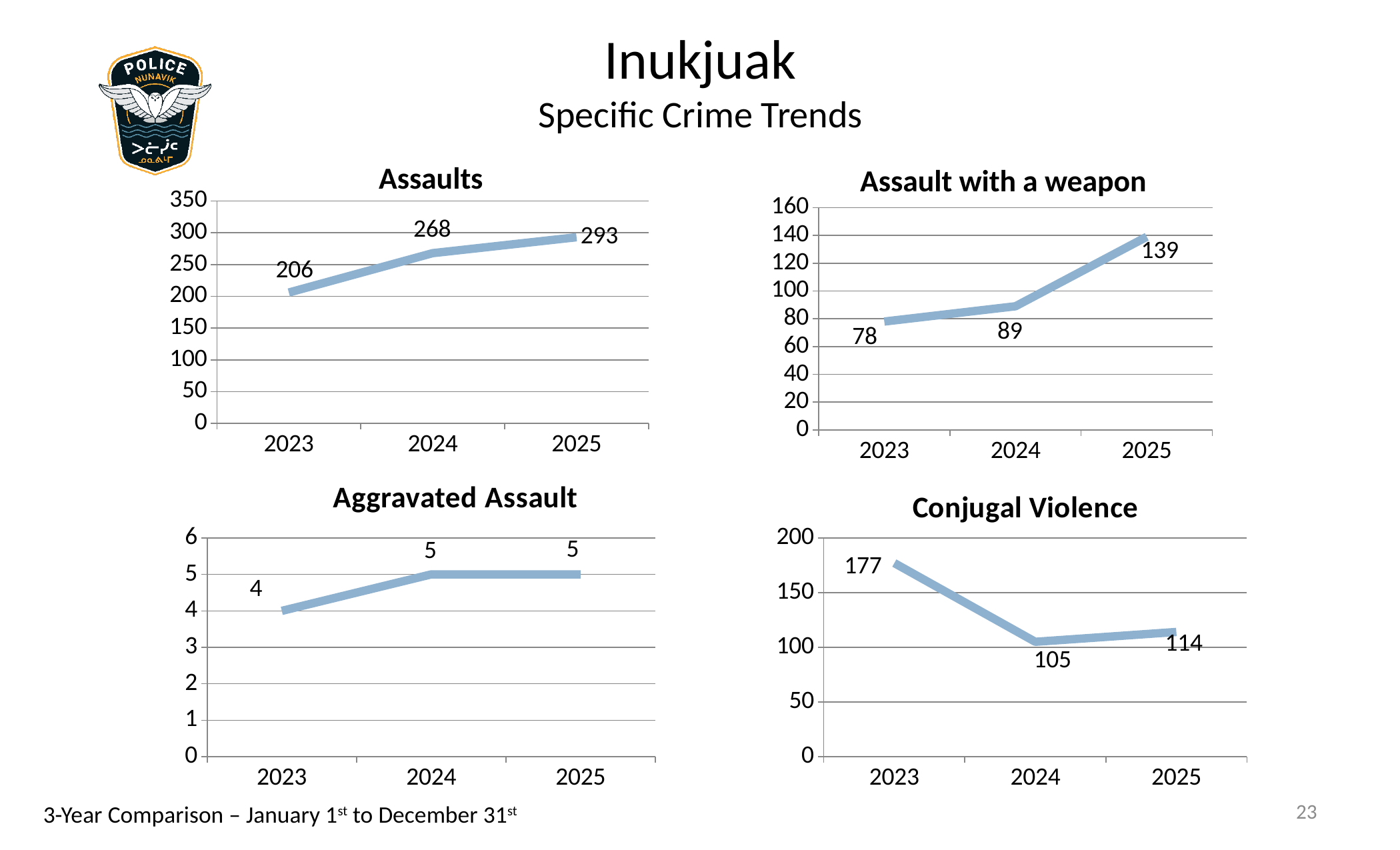
In the Aggravated Assault chart, which is larger, the value for 2023 or the value for 2024? 2024 In the Assault with a weapon chart, is the value for 2024 greater or less than 100? less How many charts are shown on the slide? 4 In the Conjugal Violence chart, which year has the highest value? 2023 In the Assault with a weapon chart, which year has the lowest value? 2023 In the Assault with a weapon chart, what is the value for 2025? 139 In the Assault with a weapon chart, do the values rise or fall from 2023 to 2025? rise In the Assaults chart, what is the difference between the 2025 and 2023 values? 87 What kind of chart is the Conjugal Violence chart? line chart In the Conjugal Violence chart, what is the difference between the 2023 and 2024 values? 72 How many data points are plotted in the Aggravated Assault chart? 3 In the Assaults chart, what is the value for 2024? 268